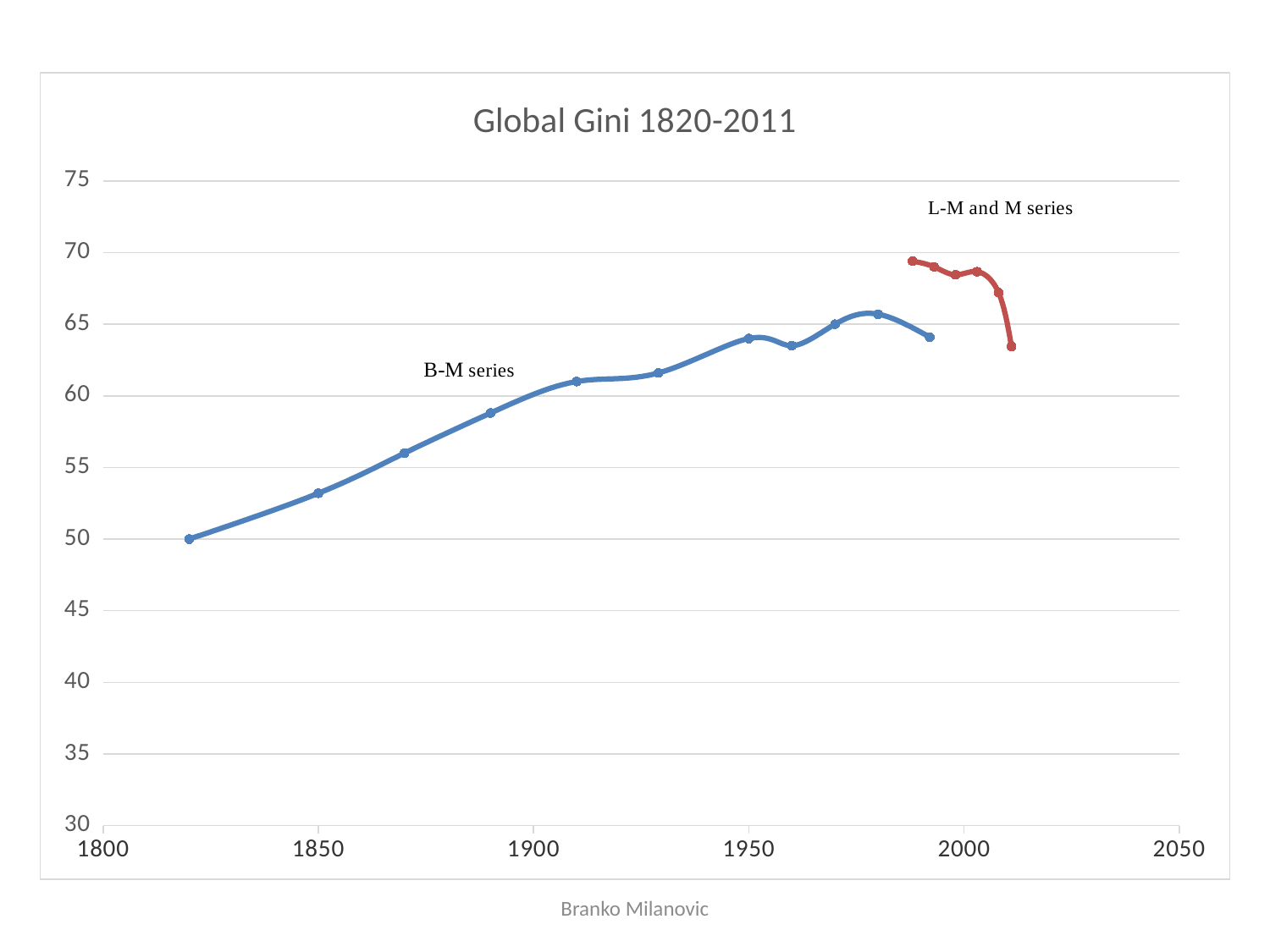
Is the value of the B-M series at 1910 greater or less than 60? greater What kind of chart is shown on the slide? line chart Does the L-M and M series rise or fall from its first point to its last point? fall Which series reaches the higher peak value, the B-M series or the L-M and M series? L-M and M series Is the first value of the L-M and M series (around 1988) greater or less than 70? less How many series are plotted on the chart? 2 Does the B-M series generally rise or fall from 1820 to 1980? rise What is the title of the chart? Global Gini 1820-2011 What colour is the line for the B-M series? blue Is the last value of the L-M and M series (around 2011) greater or less than 65? less What is the value of the B-M series at 1820? 50